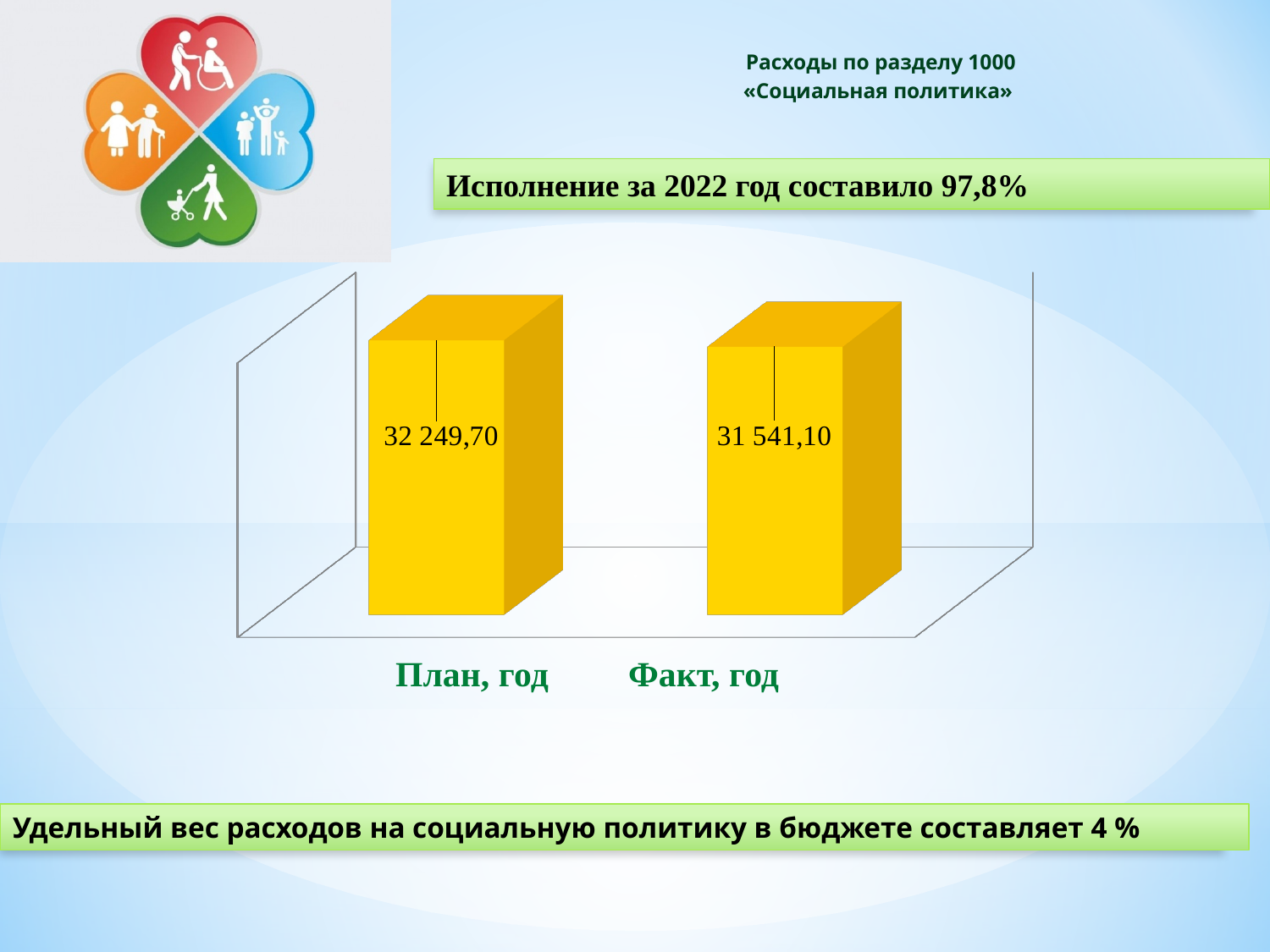
Do the values rise or fall from План, год to Факт, год? fall How many bars are shown in the chart? 2 Is the value for План, год larger or smaller than the value for Факт, год? larger What is the value for Факт, год? 31 541,10 What is the difference between the values for План, год and Факт, год? 708,60 What kind of chart is shown on the slide? bar chart Which category has the higher value? План, год What is the value for План, год? 32 249,70 Which category has the lower value? Факт, год What colour are the bars in the chart? yellow What are the two category labels on the x axis of the chart? План, год and Факт, год